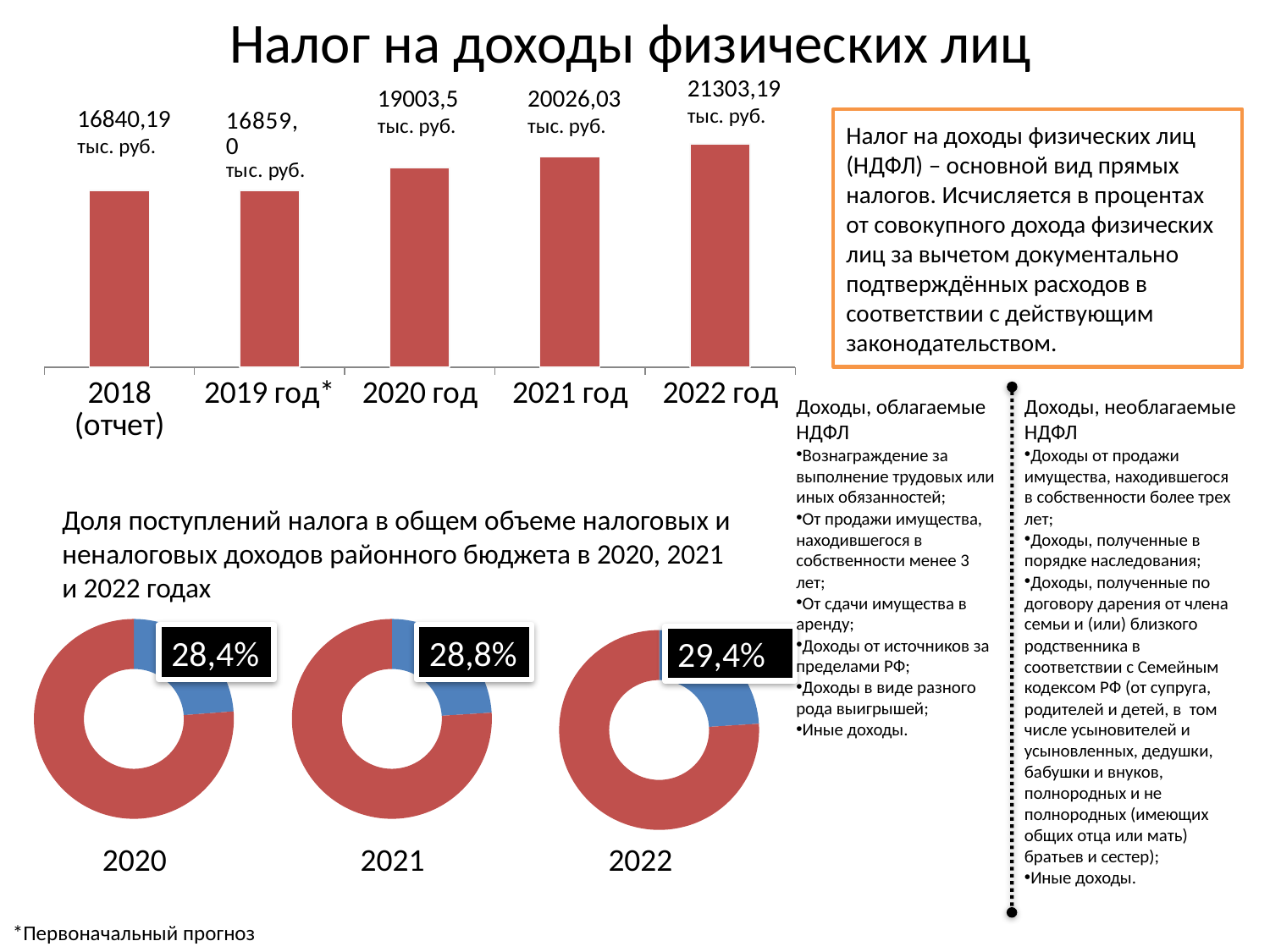
In the bar chart at the top of the slide, what is the value for 2018 (отчет)? 16840,19 тыс. руб. In the bar chart at the top of the slide, do the values rise or fall from 2018 to 2022? rise In the bar chart at the top of the slide, is the value for 2021 год larger or smaller than the value for 2020 год? larger In the bar chart at the top of the slide, which category has the lowest value? 2018 (отчет) In the bar chart at the top of the slide, which year has the highest value? 2022 год In the bar chart at the top of the slide, what is the value for 2020 год? 19003,5 тыс. руб. How many bars are in the bar chart at the top of the slide? 5 In the bar chart at the top of the slide, what is the difference between the values for 2022 год and 2021 год? 1277,16 тыс. руб. In the donut charts at the bottom of the slide, what share is shown for 2021? 28,8% What kind of chart is shown at the top left of the slide? bar chart In the donut charts at the bottom of the slide, which year has the highest share? 2022 In the bar chart at the top of the slide, what is the value for 2022 год? 21303,19 тыс. руб.